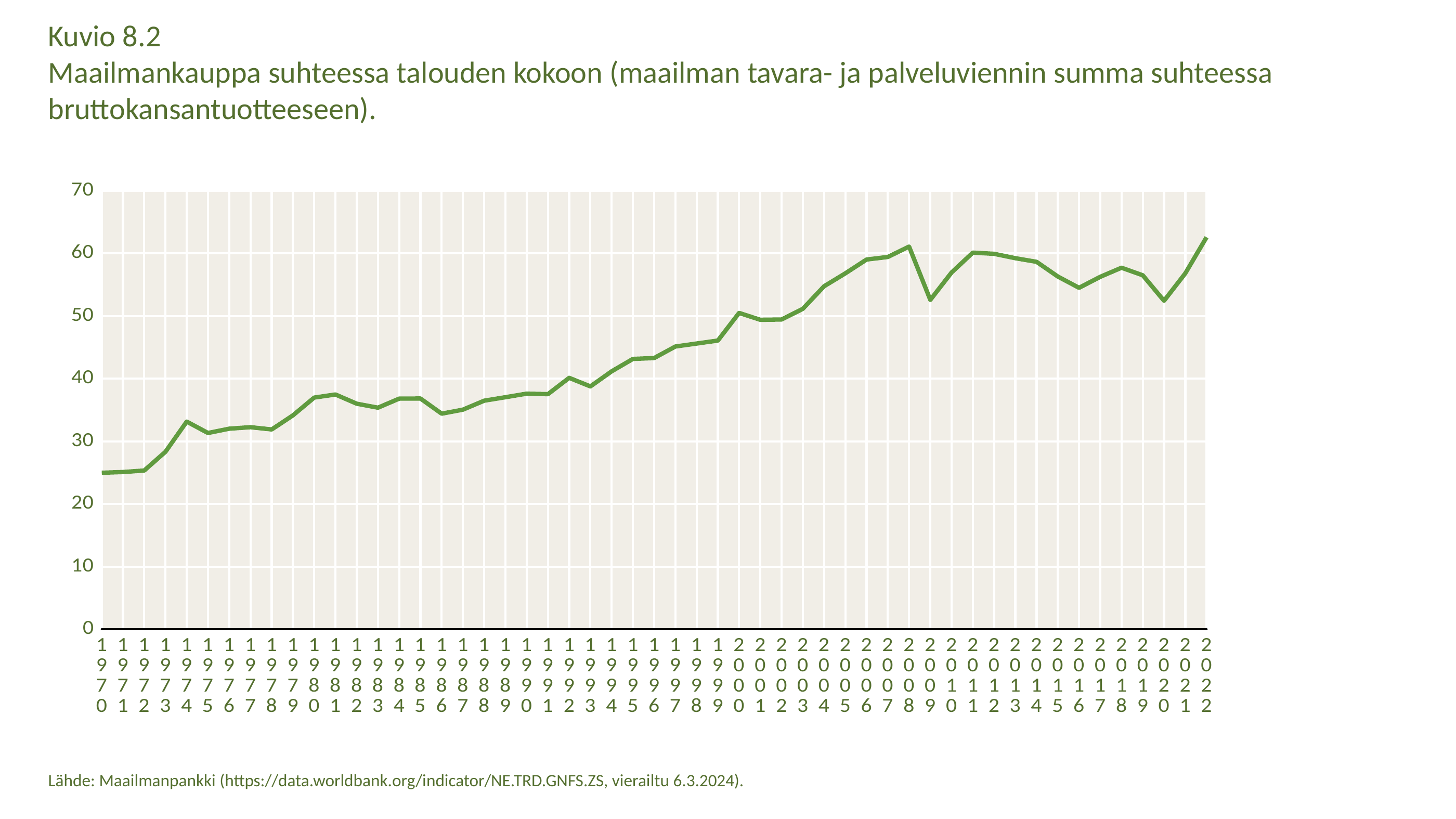
How many years are plotted along the x axis? 53 What is the first year shown on the x axis? 1970 Is the value for 2022 greater or less than 60? greater Which year has a higher value, 2019 or 2020? 2019 Overall, does the value rise or fall from 1970 to 2022? rise What is the last year shown on the x axis? 2022 Is the value for 1990 greater or less than 40? less Is the value for 1970 greater or less than 30? less What kind of chart is shown on the slide? line chart Which year has a higher value, 2008 or 2009? 2008